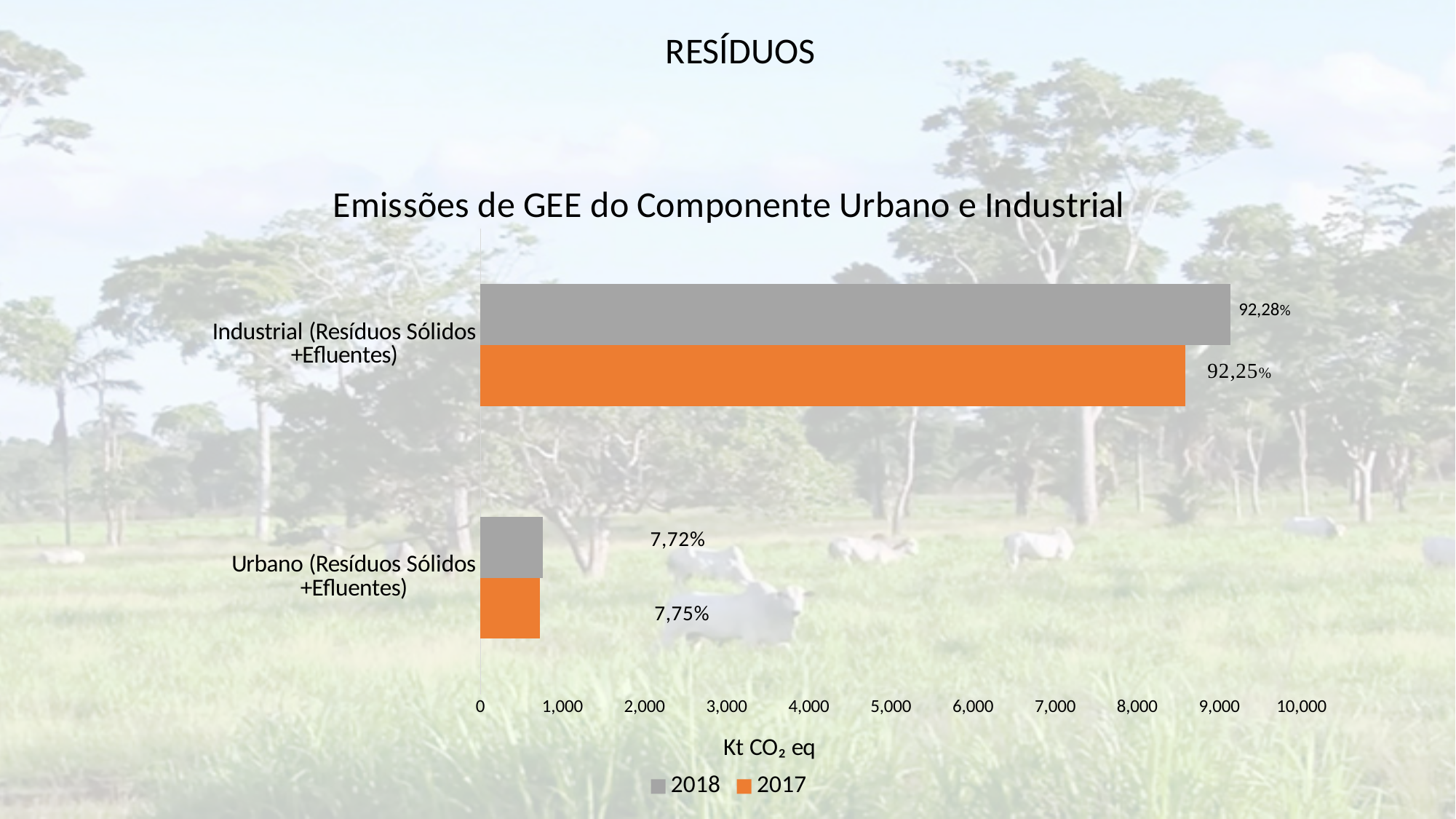
What data label is shown on the 2018 bar for Industrial (Resíduos Sólidos +Efluentes)? 92,28% What data label is shown on the 2017 bar for Industrial (Resíduos Sólidos +Efluentes)? 92,25% How many series does the legend list? 2 What data label is shown on the 2017 bar for Urbano (Resíduos Sólidos +Efluentes)? 7,75% What kind of chart is shown on the slide? bar chart For Industrial (Resíduos Sólidos +Efluentes), which year has the larger value, 2018 or 2017? 2018 What data label is shown on the 2018 bar for Urbano (Resíduos Sólidos +Efluentes)? 7,72% Which category has the lowest emissions in 2017? Urbano (Resíduos Sólidos +Efluentes) Which category has the highest emissions in 2018? Industrial (Resíduos Sólidos +Efluentes) What is the title of the chart? Emissões de GEE do Componente Urbano e Industrial How many categories are shown on the chart? 2 Is the 2017 value for Industrial (Resíduos Sólidos +Efluentes) greater or less than 8,000 Kt CO₂ eq? greater